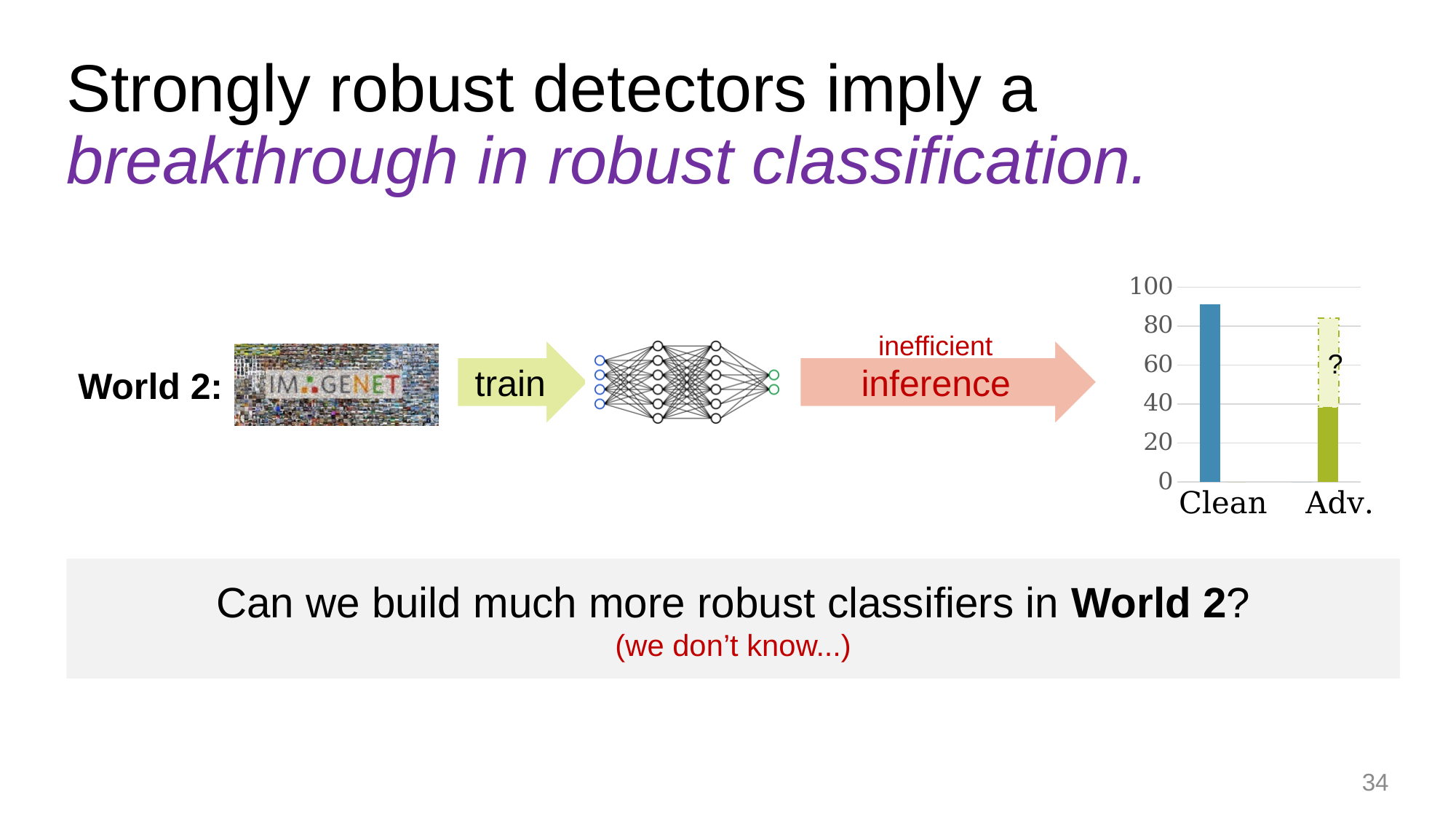
How many categories are shown on the x axis of the bar chart? 2 Which category has the taller solid bar in the chart, Clean or Adv.? Clean Is the value of the Clean bar greater or less than 80? greater What is the highest tick value shown on the y axis of the chart? 100 What symbol is printed inside the dashed extension of the Adv. bar? ? What kind of chart is shown on the right of the slide? bar chart Which category has the highest solid bar in the chart? Clean Is the value of the solid Adv. bar greater or less than 60? less Which category has the lowest solid bar in the chart? Adv. Is the value of the Clean bar greater or less than 100? less